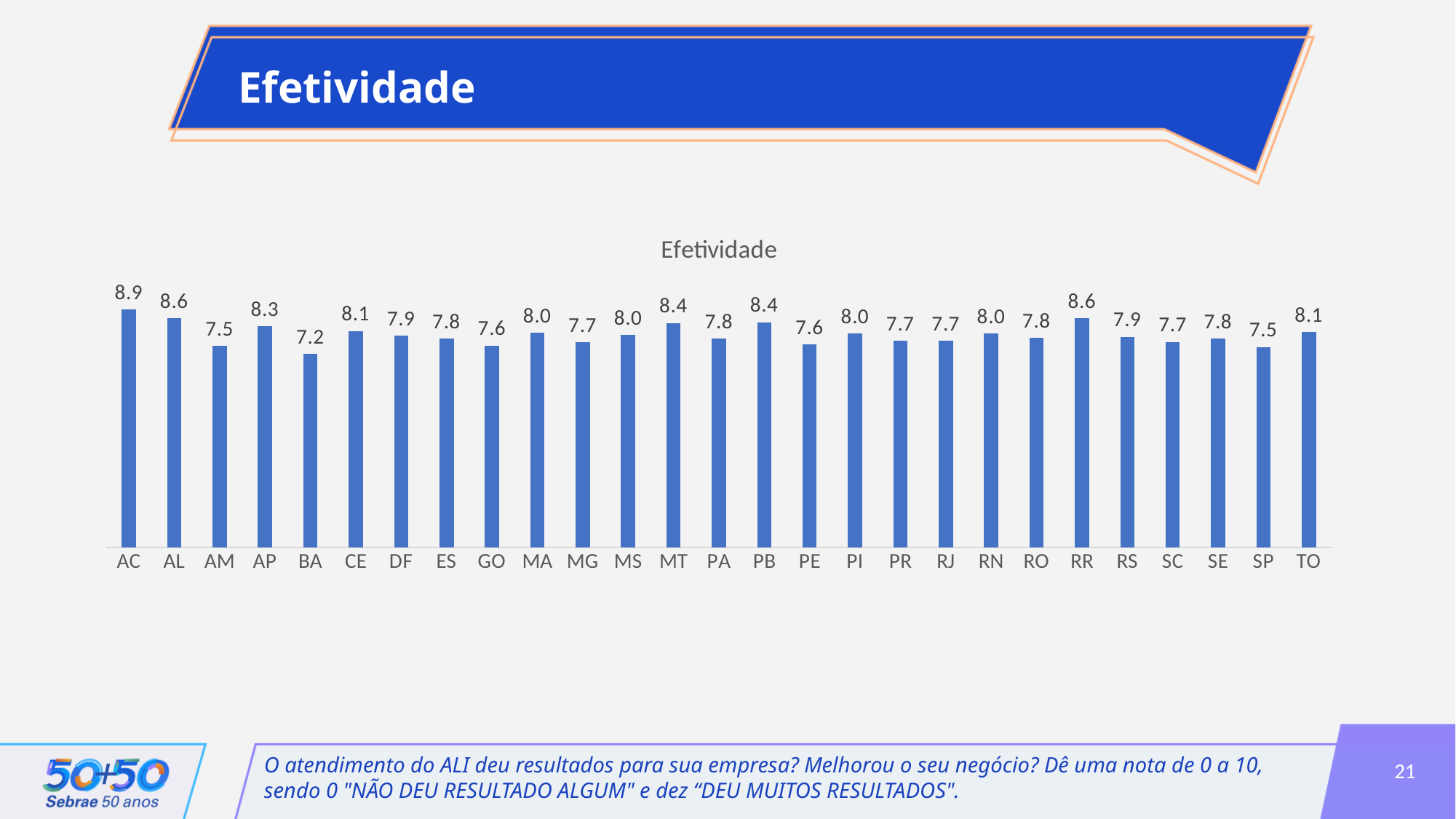
What is the Efetividade value for MT? 8.4 What is the Efetividade value for SP? 7.5 What is the difference between the Efetividade values for AC and BA? 1.7 Which has a higher Efetividade value, PB or PE? PB How many states are shown in the chart? 27 What kind of chart is shown on the slide? Bar chart What is the Efetividade value for BA? 7.2 What is the difference between the Efetividade values for RR and RS? 0.7 Which state has the lowest Efetividade value? BA Which has a higher Efetividade value, AP or AM? AP Which state has the highest Efetividade value? AC What is the Efetividade value for AC? 8.9